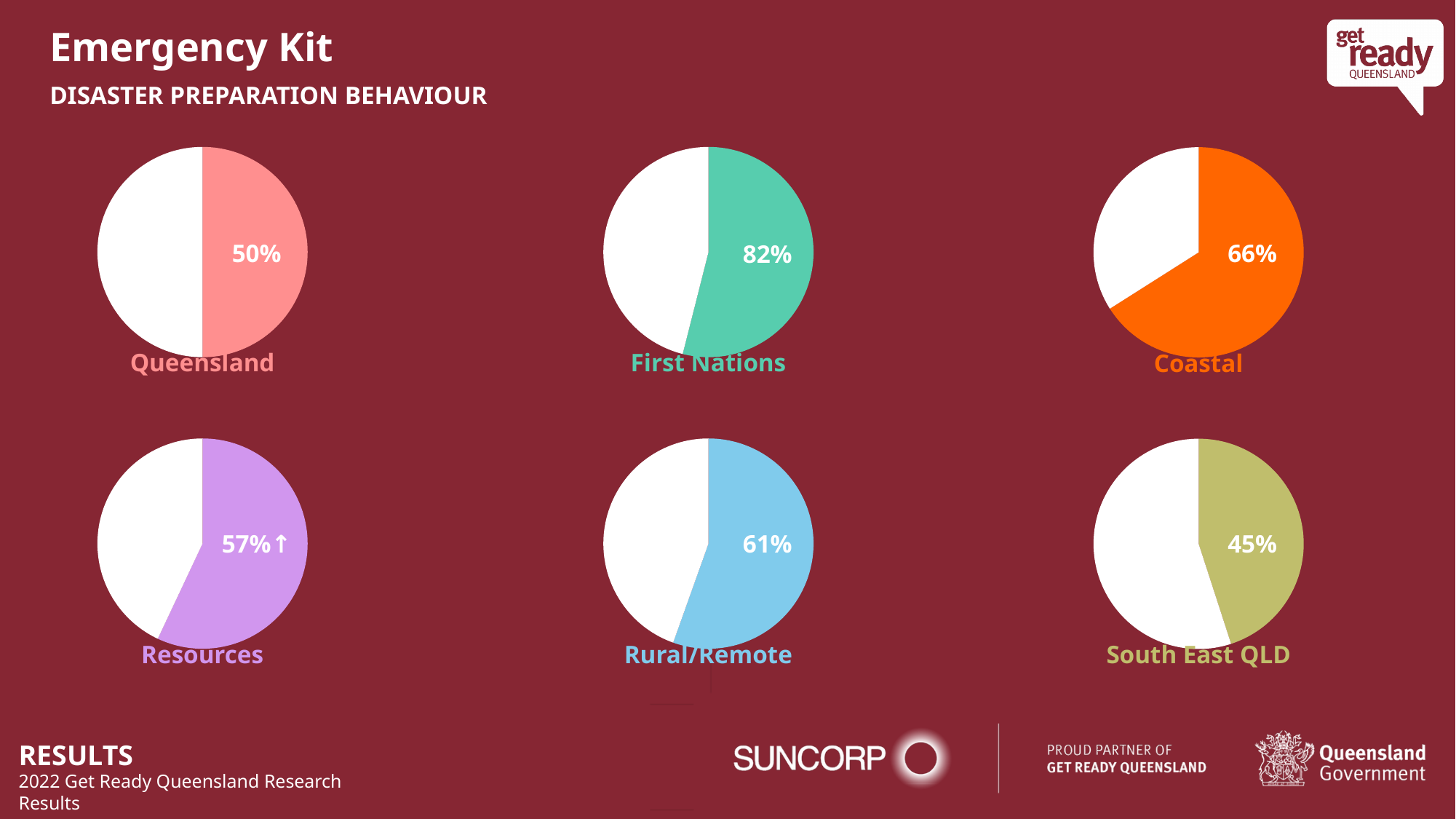
In the Resources pie chart, what percentage is shown on the purple slice? 57% How many pie charts are shown on the slide? 6 Which shows a larger percentage: the Coastal pie chart or the Rural/Remote pie chart? Coastal In the Rural/Remote pie chart, what percentage is shown? 61% In the South East QLD pie chart, what percentage is shown on the coloured slice? 45% In the Queensland pie chart, what percentage does the coloured slice show? 50% Across the six pie charts on the slide, which group has the highest labelled percentage? First Nations In the First Nations pie chart, what percentage is labelled on the coloured slice? 82% In the Coastal pie chart, what value is printed on the orange slice? 66% What is the difference between the percentage shown in the First Nations pie chart and the percentage shown in the Queensland pie chart? 32% What type of chart is used to show the Coastal value? Pie chart Across the six pie charts on the slide, which group has the lowest labelled percentage? South East QLD